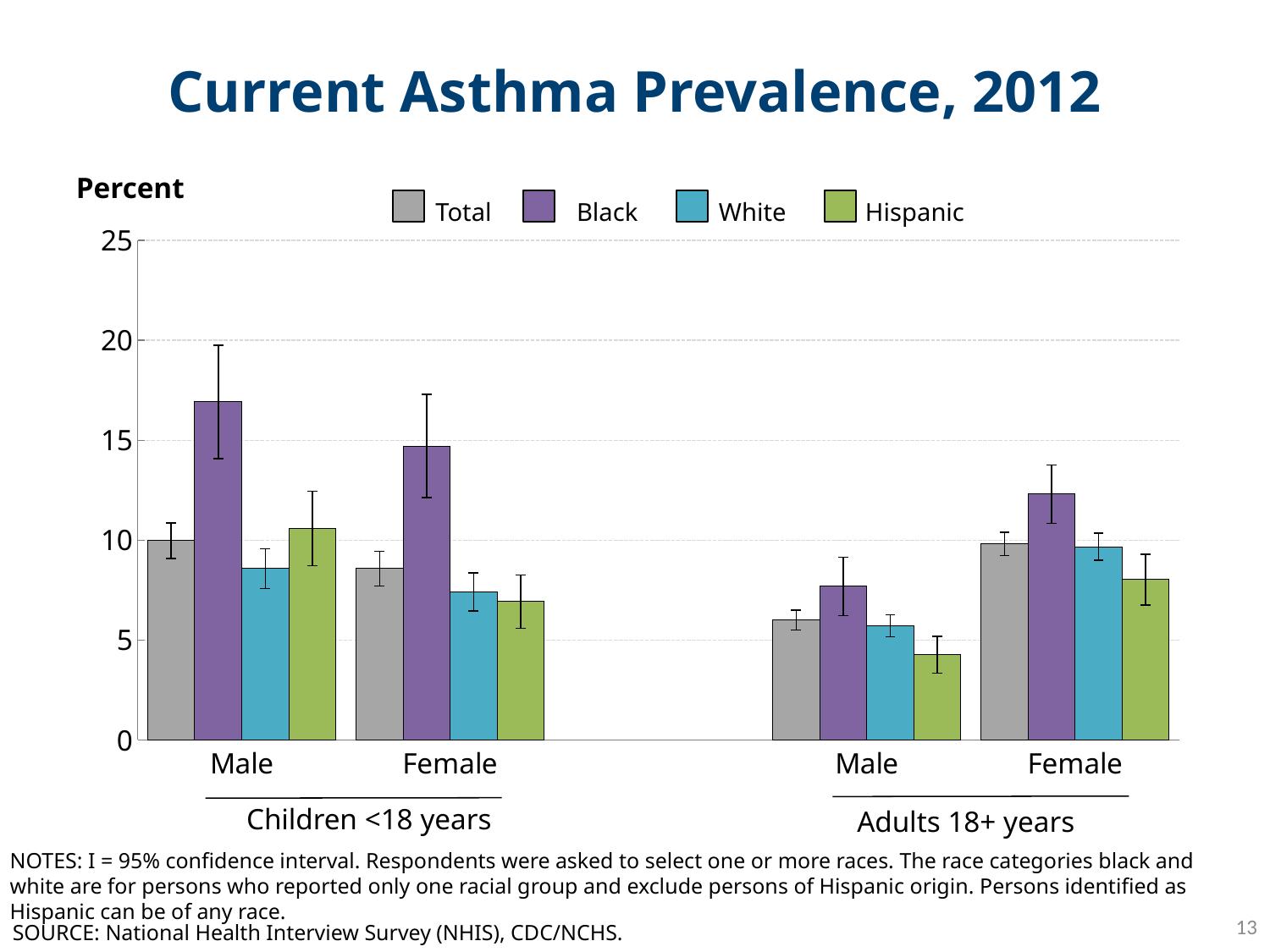
Which series has the lowest bar in the whole chart? Hispanic (Adults 18+ years, Male) Is the value for Black among male children greater or less than 15? greater Among male children, which is larger, the Black bar or the White bar? Black What is the title of the chart? Current Asthma Prevalence, 2012 Is the value for White among female children greater or less than 10? less Which series has the highest bar in the whole chart? Black (Children <18 years, Male) Among female adults, which is larger, the White bar or the Hispanic bar? White What kind of chart is shown on the slide? bar chart What are the four legend entries, in order? Total, Black, White, Hispanic Is the value for Hispanic among male adults greater or less than 5? less How many series does the legend list? 4